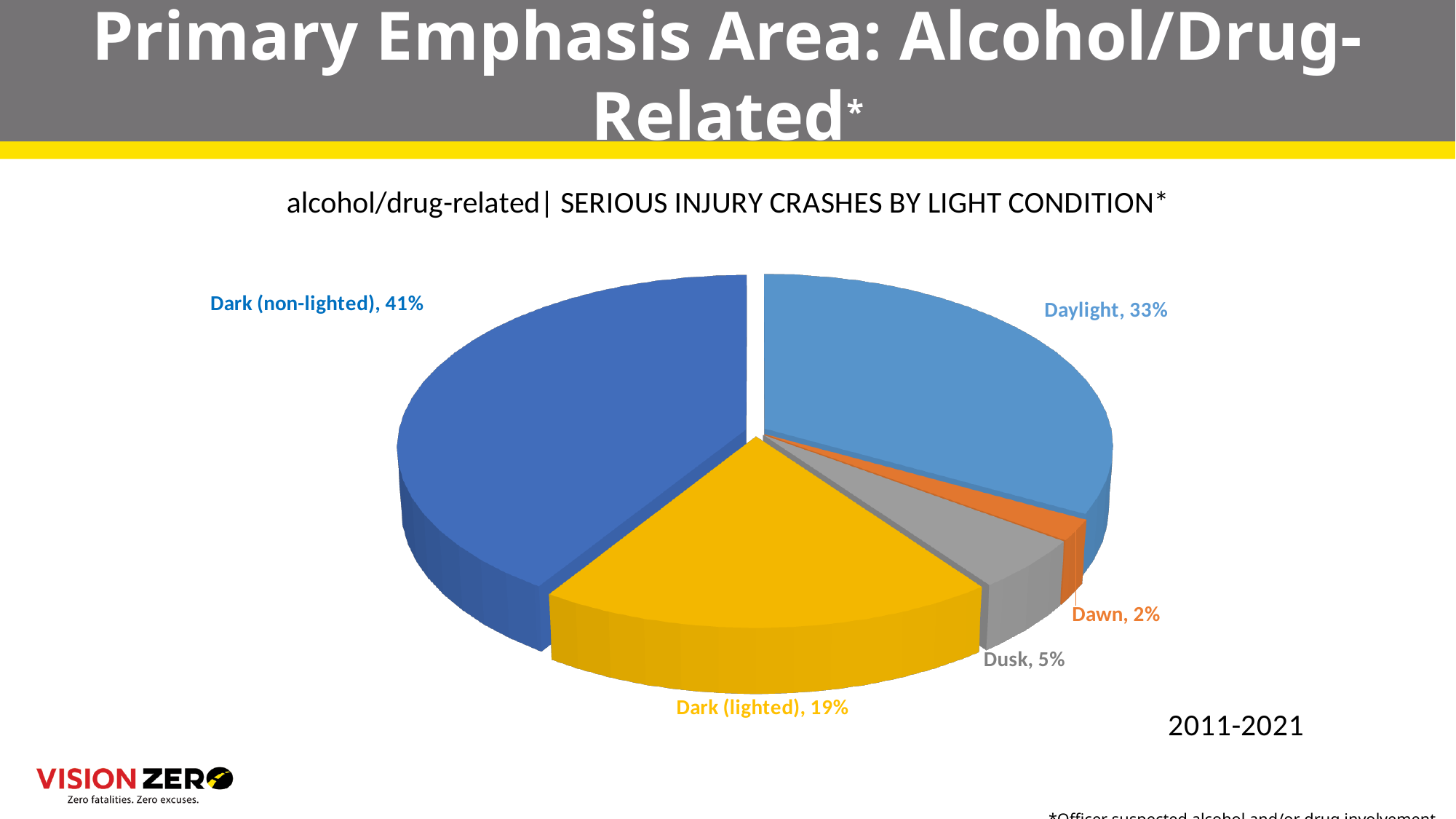
What share of crashes occurred in Daylight? 33% What share of crashes occurred at Dusk? 5% What time period does the chart cover? 2011-2021 How many light condition categories are shown in the pie chart? 5 What kind of chart is shown on the slide? Pie chart What share of crashes occurred at Dawn? 2% What share of crashes occurred in Dark (lighted) conditions? 19% Which light condition has the smallest share of crashes? Dawn What share of alcohol/drug-related serious injury crashes occurred in Dark (non-lighted) conditions? 41% What is the difference in percentage points between Dark (non-lighted) and Daylight? 8 Which has a larger share, Dark (lighted) or Dusk? Dark (lighted) Which light condition has the largest share of crashes? Dark (non-lighted)